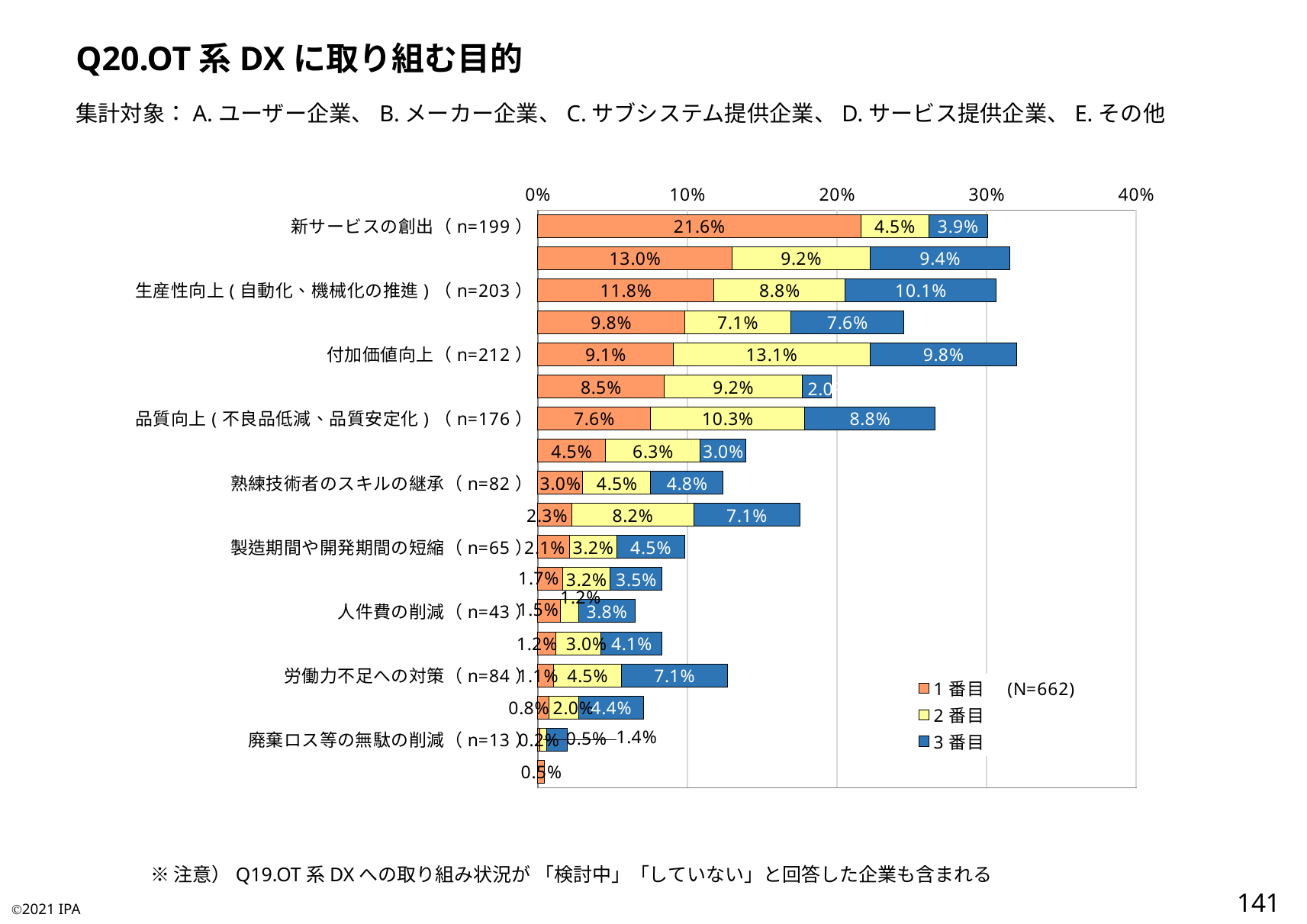
How many series does the legend list? 3 What is the 1番目 value for 新サービスの創出 (n=199)? 21.6% Which is larger: the 3番目 value for 労働力不足への対策 (n=84) or the 3番目 value for 人件費の削減 (n=43)? 労働力不足への対策 (n=84) What is the difference between the 1番目 values for 新サービスの創出 (n=199) and 生産性向上(自動化、機械化の推進) (n=203)? 9.8% What is the total of the stacked bar for 新サービスの創出 (n=199)? 30.0% What is the 3番目 value for 生産性向上(自動化、機械化の推進) (n=203)? 10.1% What is the 2番目 value for 品質向上(不良品低減、品質安定化) (n=176)? 10.3% What is the 2番目 value for 付加価値向上 (n=212)? 13.1% What N value is shown next to the legend? N=662 What kind of chart is shown on the slide? Stacked bar chart Which labeled category has the highest 1番目 value? 新サービスの創出 (n=199) What is the total of the stacked bar for 付加価値向上 (n=212)? 32.0%